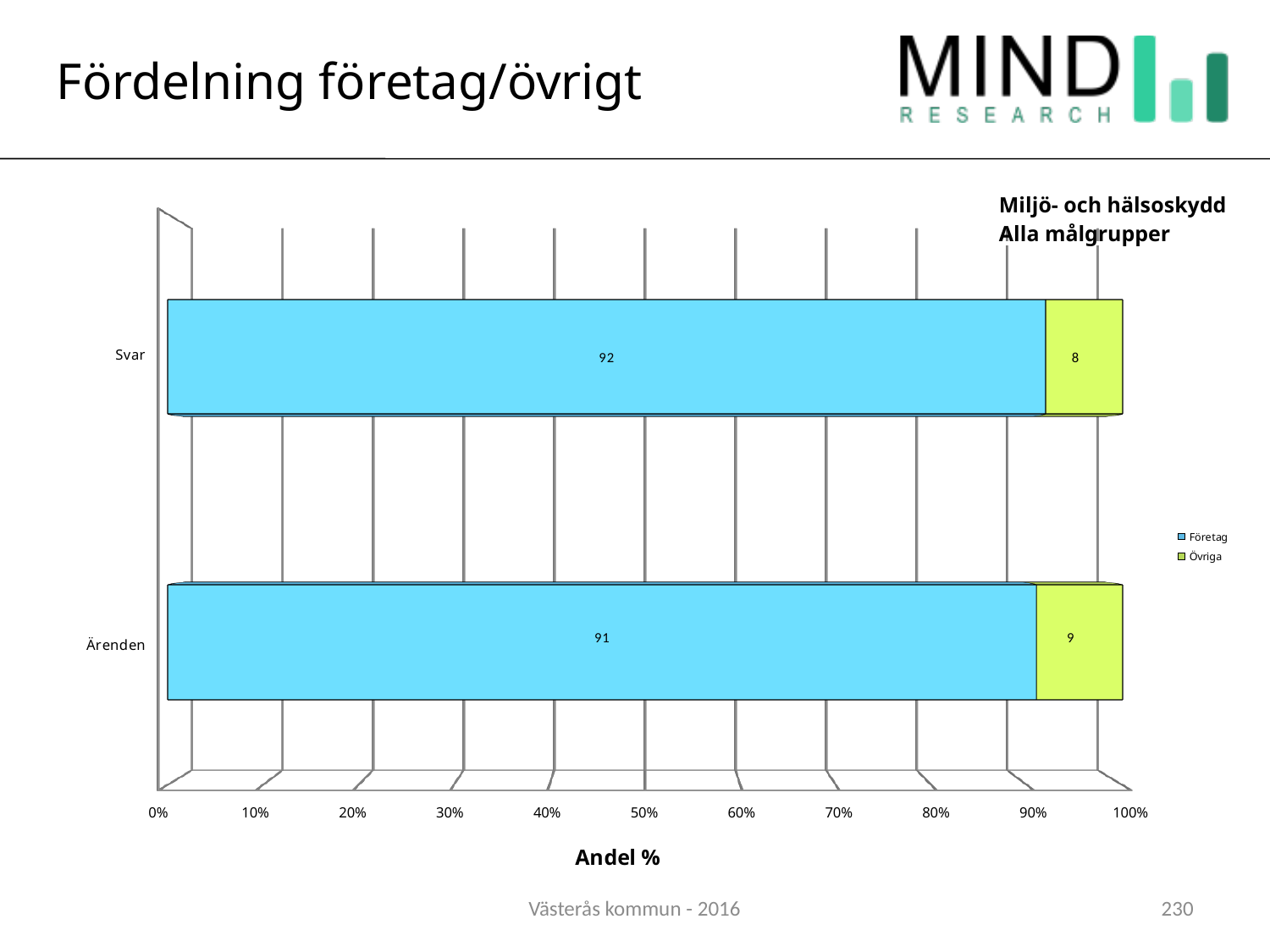
What is the label of the x axis? Andel % What kind of chart is shown on the slide? Stacked bar chart Which category has the higher Övriga value, Svar or Ärenden? Ärenden What is the difference between the Företag values for Svar and Ärenden? 1 What is the total of the Ärenden stacked bar? 100 How many categories are shown on the y axis? 2 How many series does the legend list? 2 What is the value for Företag in the Svar bar? 92 What is the value for Övriga in the Svar bar? 8 What is the total of the Svar stacked bar? 100 What is the value for Företag in the Ärenden bar? 91 What is the value for Övriga in the Ärenden bar? 9